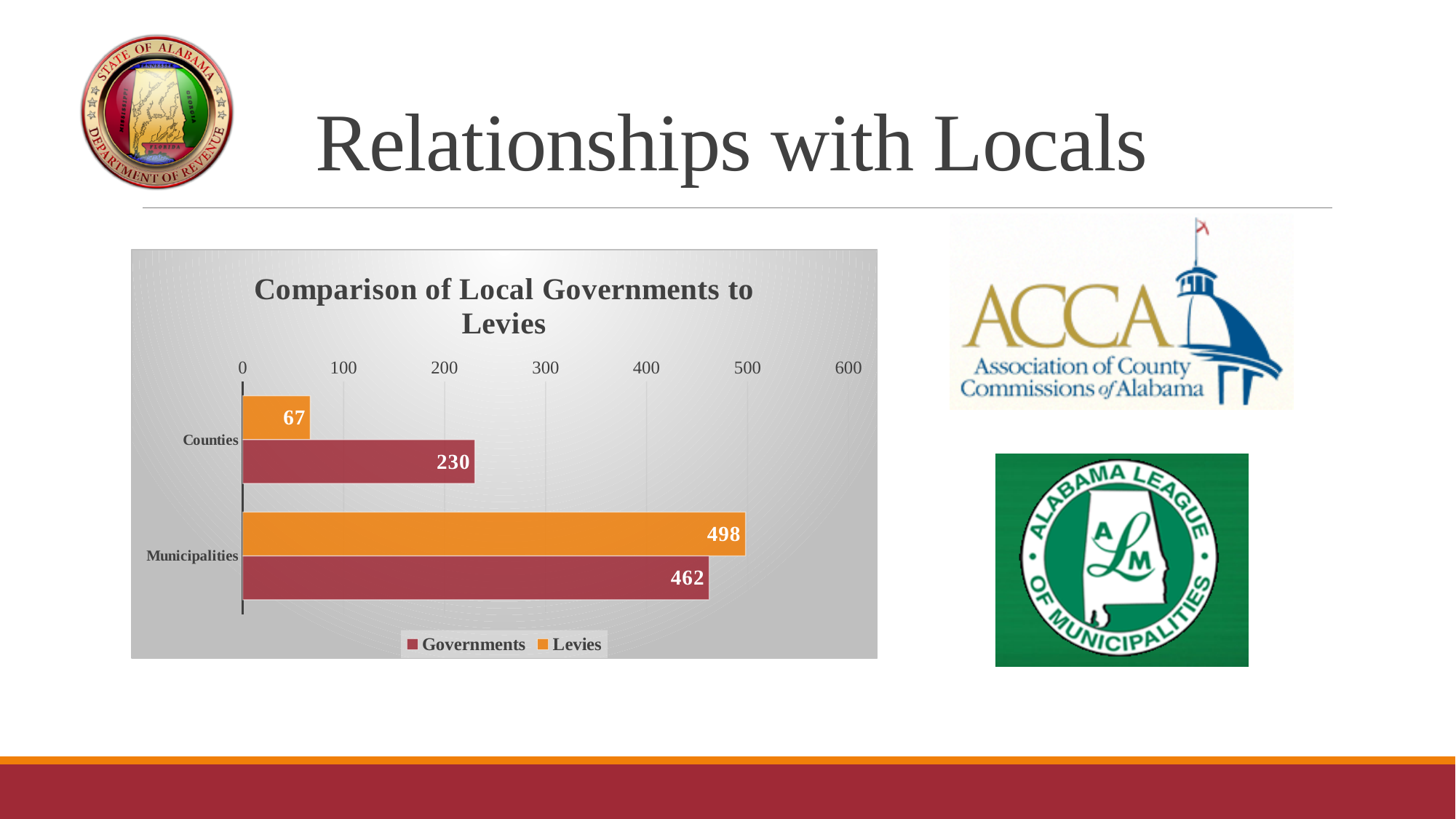
What is the value for Governments for Counties? 230 What is the difference between the Levies values for Municipalities and Counties? 431 What kind of chart is shown on the slide? Bar chart For Municipalities, which is larger, Governments or Levies? Levies Which category has the lowest Governments value? Counties What is the difference between the Governments and Levies values for Counties? 163 What is the value for Levies for Municipalities? 498 What is the value for Levies for Counties? 67 What is the value for Governments for Municipalities? 462 How many categories are shown on the chart? 2 Which category has the highest Levies value? Municipalities How many series does the legend list? 2